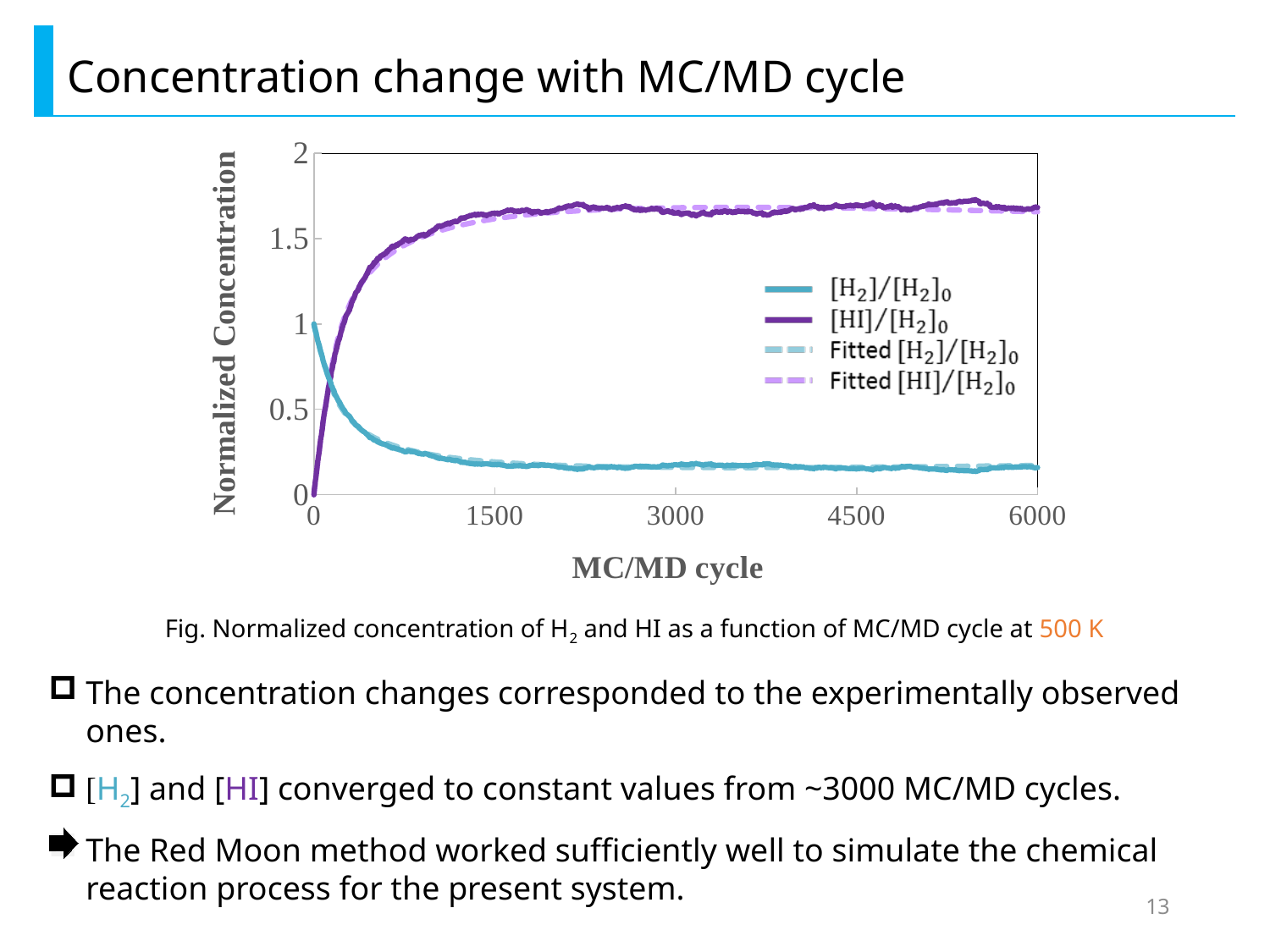
What is the value of [H2]/[H2]0 at MC/MD cycle 0? 1 How many series does the chart legend list? 4 Does the [H2]/[H2]0 series rise or fall as the MC/MD cycle increases? fall What kind of chart is shown on the slide? line chart What is the label of the y axis of the chart? Normalized Concentration Is the value of [H2]/[H2]0 at MC/MD cycle 6000 greater or less than 0.5? less What is the value of [HI]/[H2]0 at MC/MD cycle 0? 0 Is the value of [HI]/[H2]0 at MC/MD cycle 6000 greater or less than 1.5? greater At MC/MD cycle 4500, which is larger, [H2]/[H2]0 or [HI]/[H2]0? [HI]/[H2]0 Does the [HI]/[H2]0 series rise or fall as the MC/MD cycle increases? rise What is the label of the x axis of the chart? MC/MD cycle Which series reaches the highest normalized concentration on the chart? [HI]/[H2]0